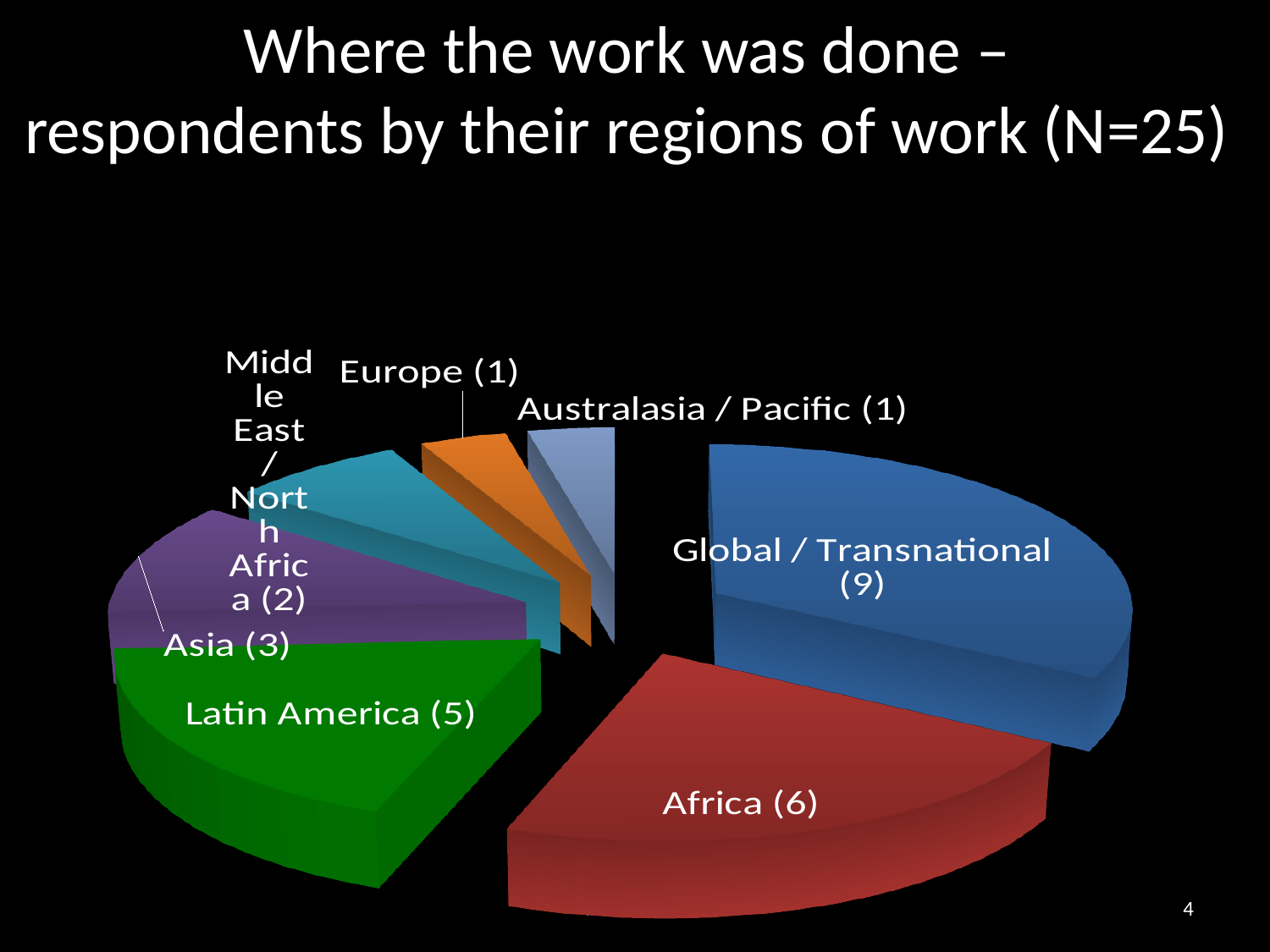
How many respondents are in the Latin America slice? 5 What kind of chart is shown on the slide? pie chart How many respondents are in the Asia slice? 3 What is the difference between the Global / Transnational count and the Africa count? 3 Which slice is larger, Africa or Latin America? Africa How many slices (regions) does the pie chart have? 7 How many respondents are in the Europe slice? 1 What is the title of the chart on the slide? Where the work was done – respondents by their regions of work (N=25) Which region has the largest slice of the pie? Global / Transnational How many respondents are in the Africa slice? 6 How many respondents are in the Middle East / North Africa slice? 2 How many respondents are in the Global / Transnational slice? 9